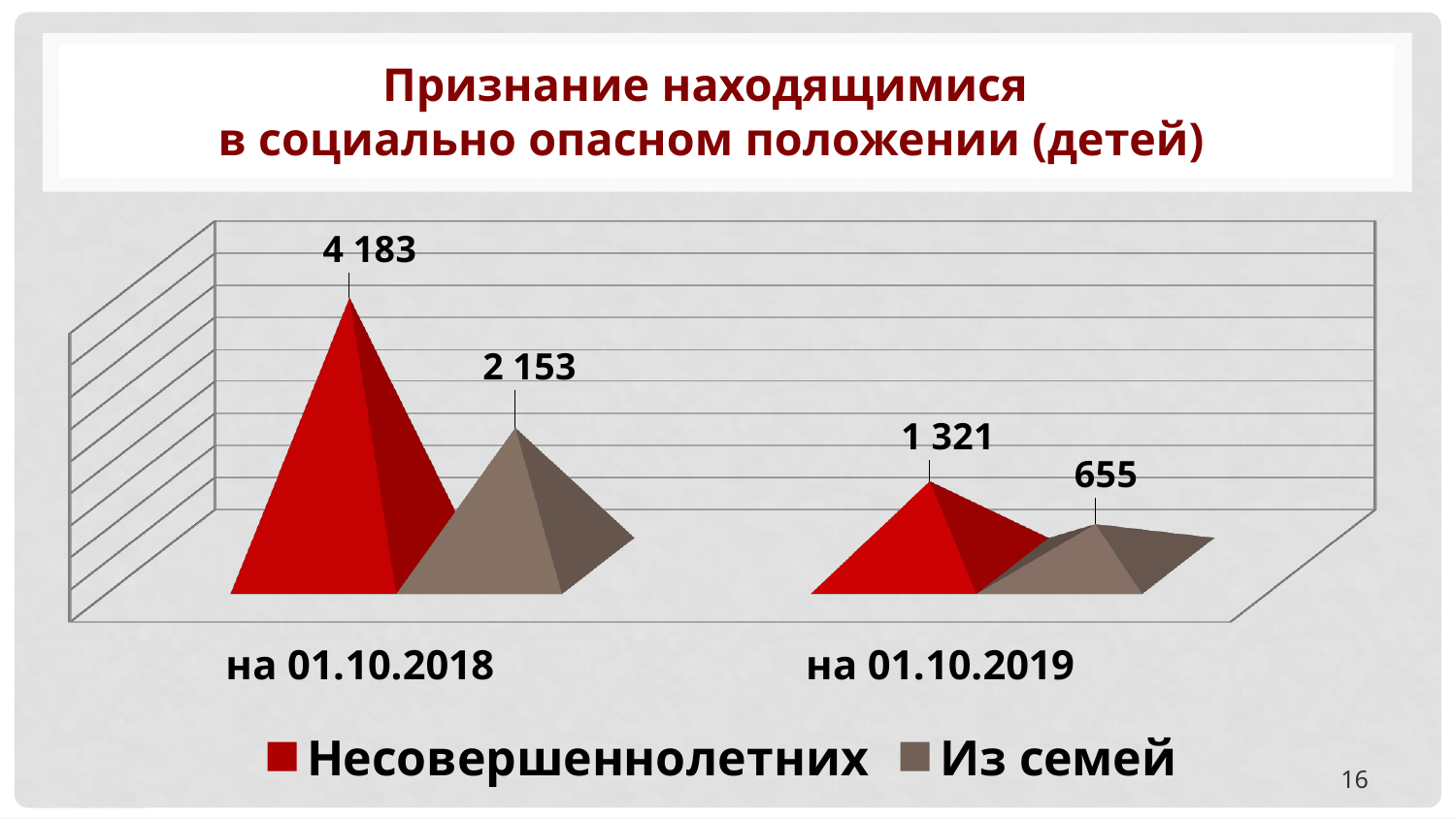
Which series has the highest value на 01.10.2018? Несовершеннолетних What is the value for Из семей на 01.10.2019? 655 What is the value for Несовершеннолетних на 01.10.2018? 4 183 What is the value for Несовершеннолетних на 01.10.2019? 1 321 How many categories are shown on the x axis? 2 How many series does the legend list? 2 What is the value for Из семей на 01.10.2018? 2 153 Which is larger: Из семей на 01.10.2018 or Несовершеннолетних на 01.10.2019? Из семей на 01.10.2018 By how much did the value for Несовершеннолетних decrease from 01.10.2018 to 01.10.2019? 2 862 Which value is the lowest on the chart? Из семей на 01.10.2019 (655) Do the values for Из семей rise or fall from 01.10.2018 to 01.10.2019? fall What is the difference between Несовершеннолетних and Из семей на 01.10.2018? 2 030